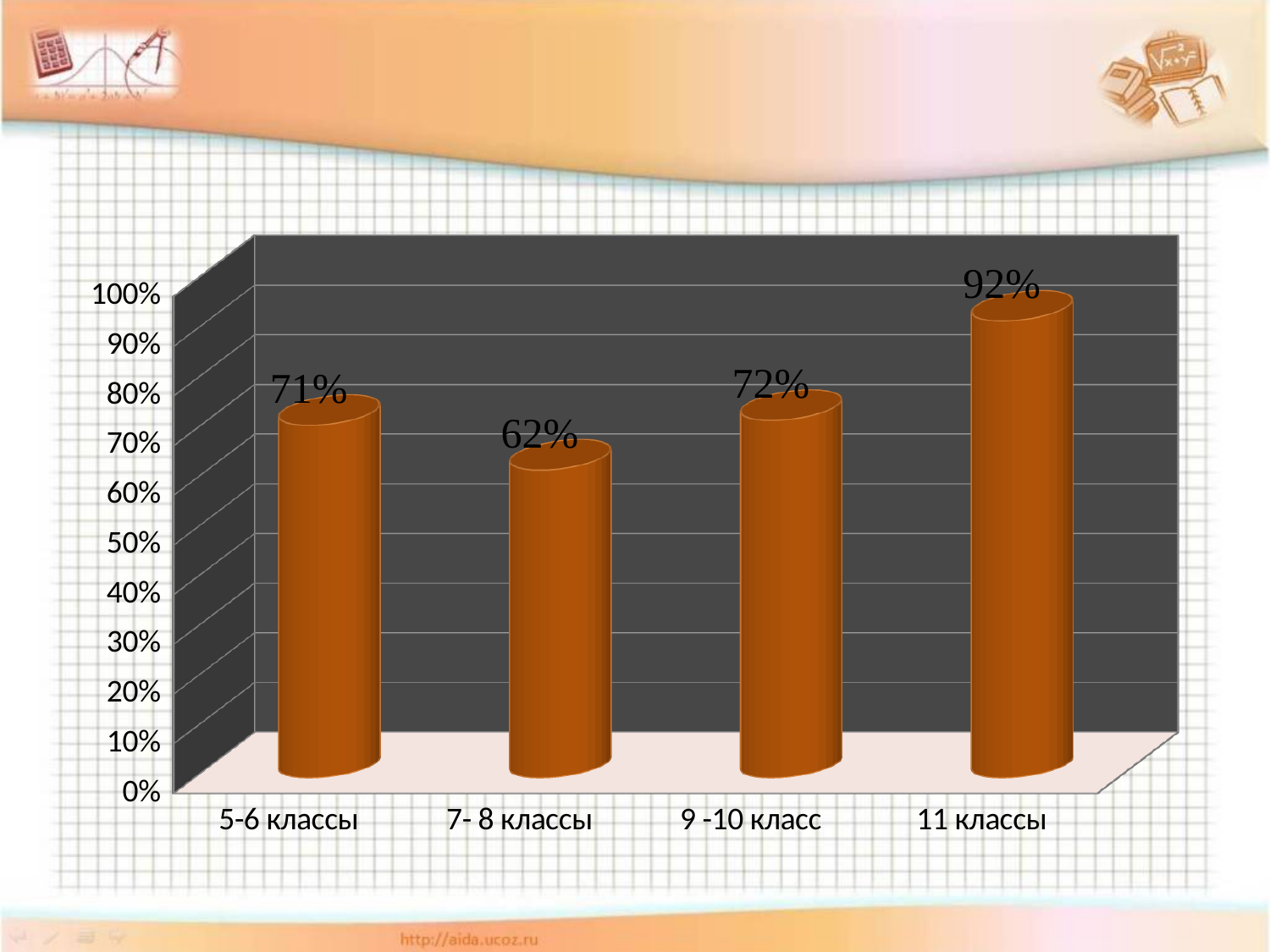
What is the value for 9 -10 класс? 72% What is the value for 11 классы? 92% What is the value for 5-6 классы? 71% What is the highest tick value shown on the vertical axis? 100% What is the value for 7- 8 классы? 62% What is the difference between the values for 11 классы and 7- 8 классы? 30% How many categories are shown on the x axis? 4 Which category has the highest value? 11 классы What kind of chart is shown on the slide? bar chart What is the difference between the values for 5-6 классы and 7- 8 классы? 9% Which is larger, the value for 5-6 классы or the value for 7- 8 классы? 5-6 классы Which category has the lowest value? 7- 8 классы